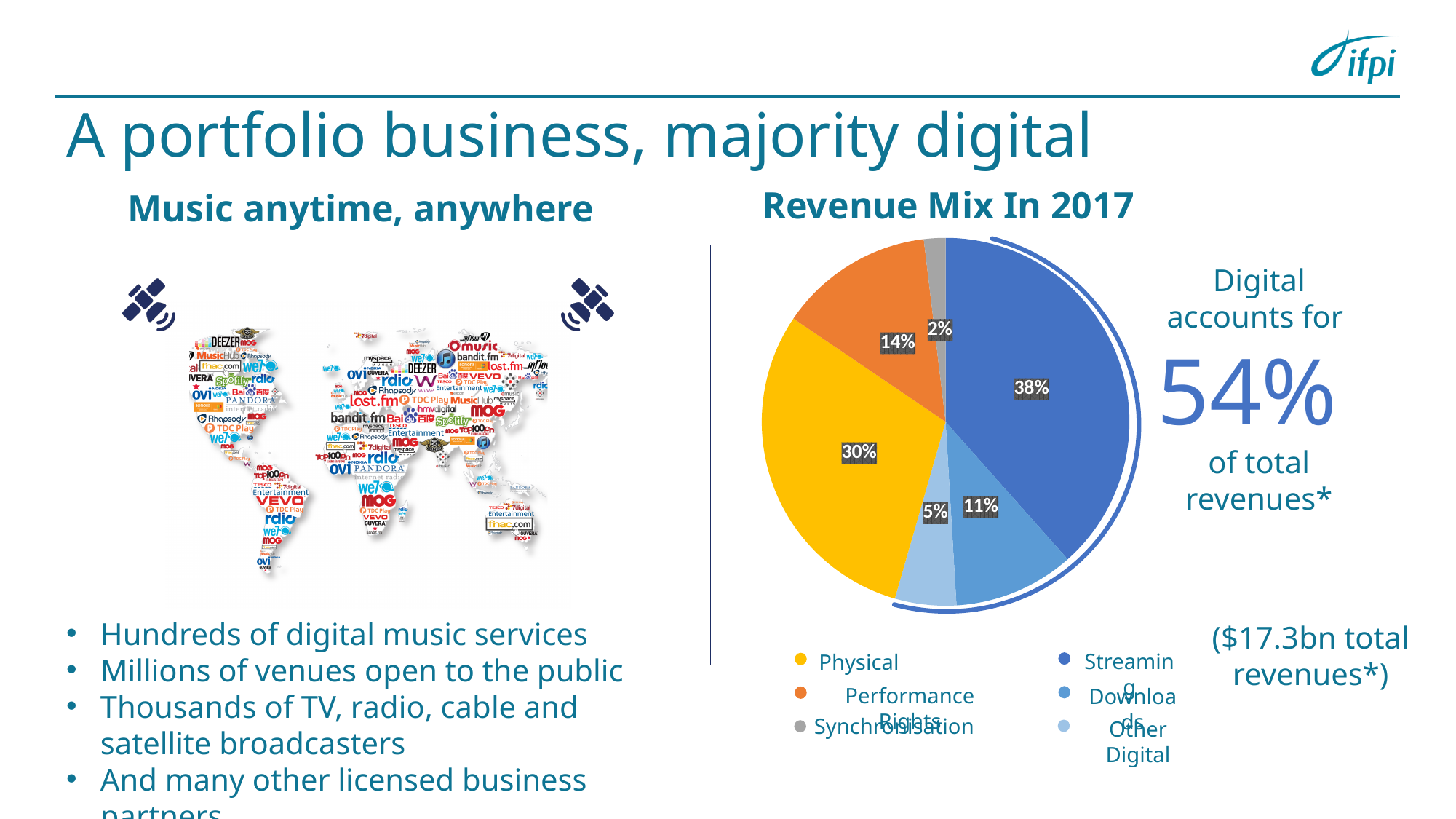
What share of revenue does Physical account for in the Revenue Mix In 2017 pie chart? 30% What percentage is shown for Downloads in the Revenue Mix In 2017 pie chart? 11% What percentage is shown for Synchronisation in the Revenue Mix In 2017 pie chart? 2% What share of revenue does Streaming account for in the Revenue Mix In 2017 pie chart? 38% Which category has the largest slice in the Revenue Mix In 2017 pie chart? Streaming What type of chart is used to show the Revenue Mix In 2017? Pie chart What colour is the Physical slice in the Revenue Mix In 2017 pie chart? Yellow In the Revenue Mix In 2017 pie chart, how many percentage points larger is Streaming than Physical? 8 Which category has the smallest slice in the Revenue Mix In 2017 pie chart? Synchronisation In the Revenue Mix In 2017 pie chart, which is larger: Performance Rights or Downloads? Performance Rights How many categories does the legend of the Revenue Mix In 2017 chart list? 6 What percentage is shown for Performance Rights in the Revenue Mix In 2017 pie chart? 14%